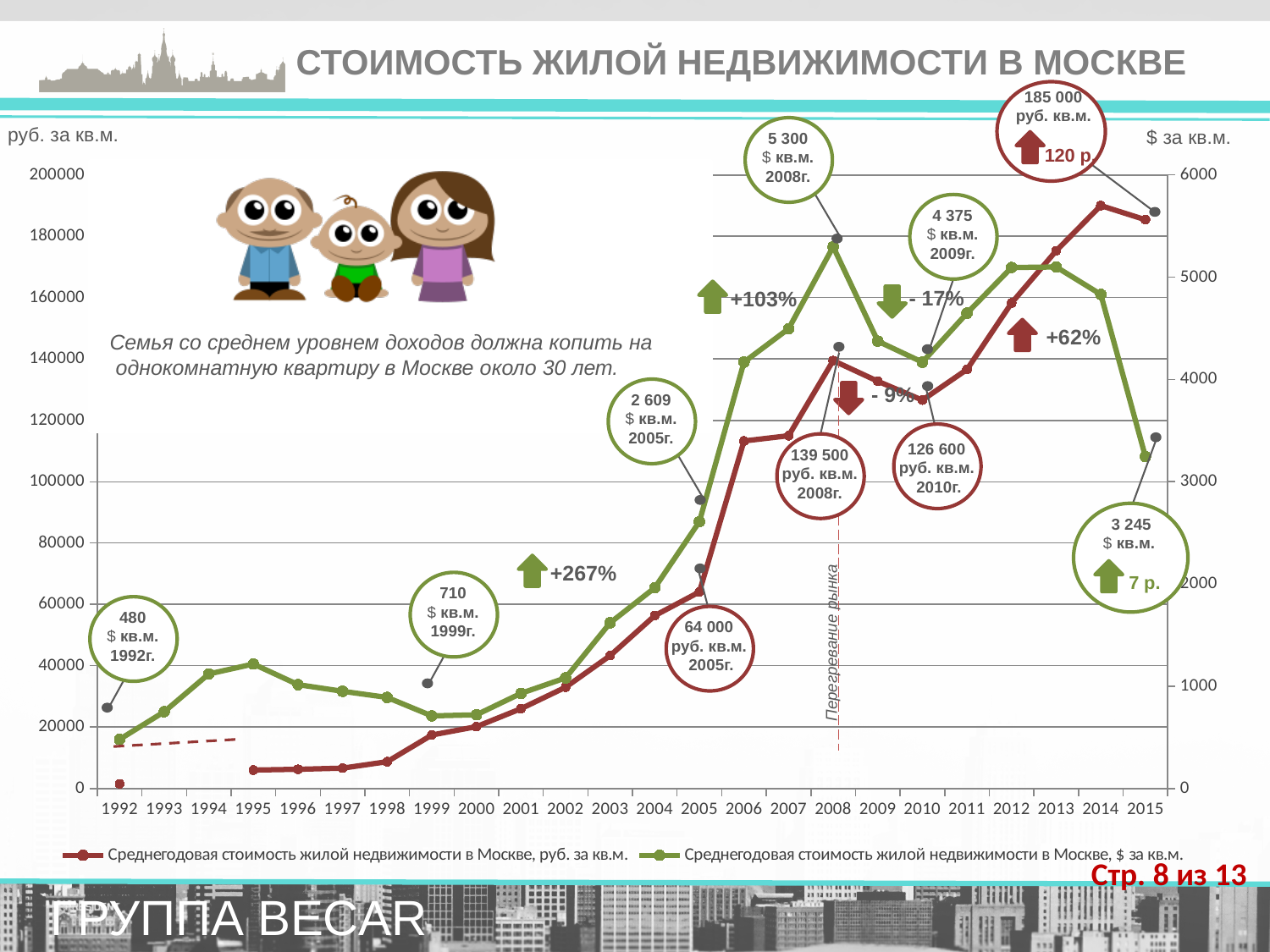
What was the average annual cost of housing in Moscow in rubles per sq.m. in 2008? 139 500 How many years are shown on the x axis? 24 What was the average annual cost of housing in Moscow in $ per sq.m. in 2008? 5 300 By how much did the $ per sq.m. value fall from 2008 (5 300) to 2009 (4 375)? 925 What type of chart is shown on the slide? line chart Is the ruble per sq.m. value for 2000 greater or less than 40000? less In which year was the $ per sq.m. value highest? 2008 What was the ruble per sq.m. value in 2010? 126 600 What is the difference between the ruble per sq.m. values in 2008 (139 500) and 2010 (126 600)? 12 900 How many series does the legend list? 2 What was the ruble per sq.m. value in 2005? 64 000 What was the $ per sq.m. value in 1992? 480